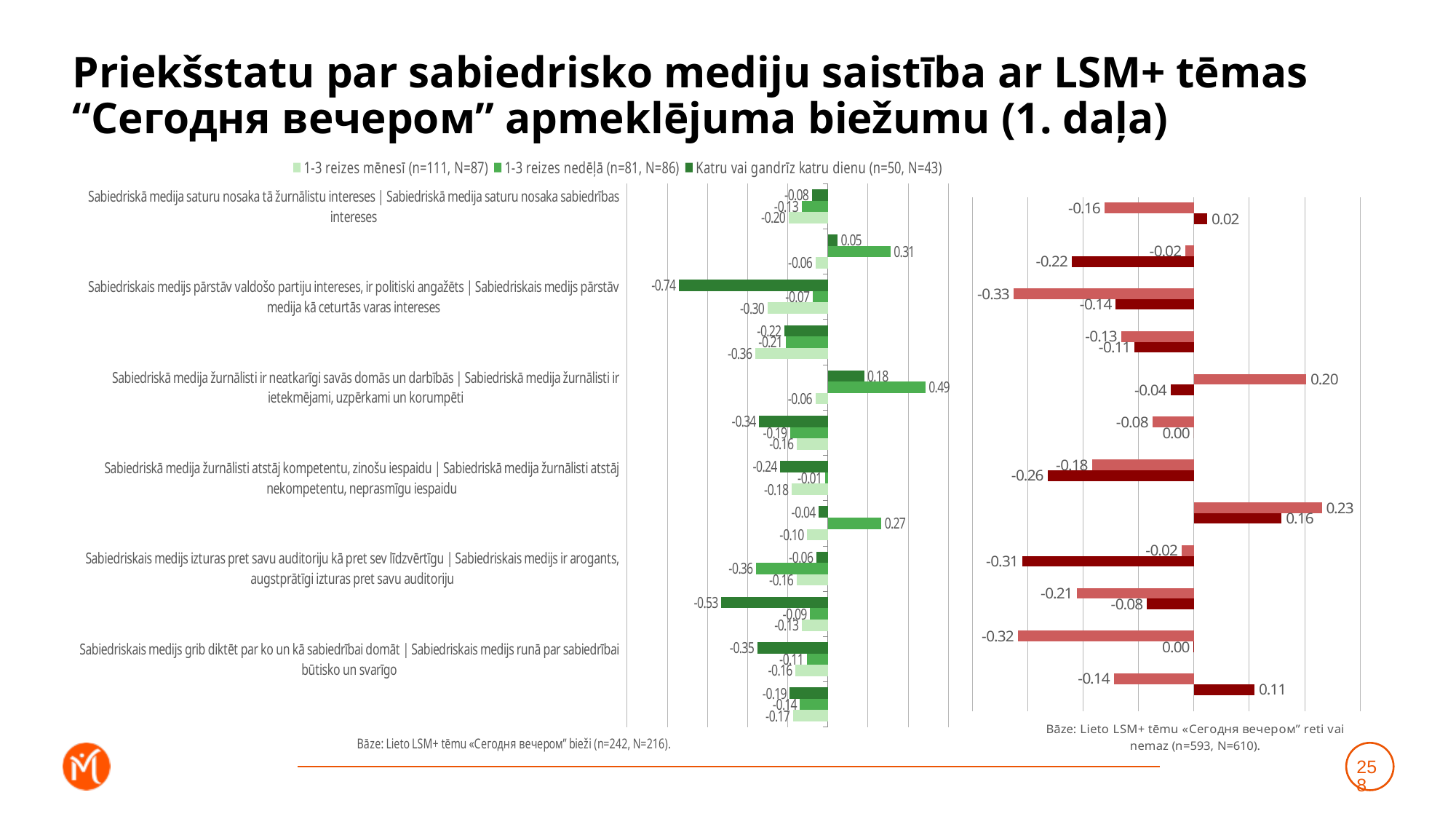
What is the base (n) stated in the note under the left green chart? n=242 Which chart has the larger maximum labelled value, the left green chart or the right red chart? the left green chart In the left green chart, what is the difference between the highest labelled value (0.49) and the lowest labelled value (-0.74)? 1.23 How many series does the legend above the left chart list? 3 In the right red chart, what is the highest value labelled on any bar? 0.23 In the left green chart, what value is labelled on the dark green bar in the topmost group? -0.08 How many groups of bars are plotted in the right red chart? 12 In the left green chart, what is the lowest value labelled on any bar? -0.74 What kind of chart is the green chart on the left of the slide? bar chart In the left green chart, what is the highest value labelled on any bar? 0.49 In the right red chart, what is the lowest value labelled on any bar? -0.33 What is the first entry in the legend above the left chart? 1-3 reizes mēnesī (n=111, N=87)